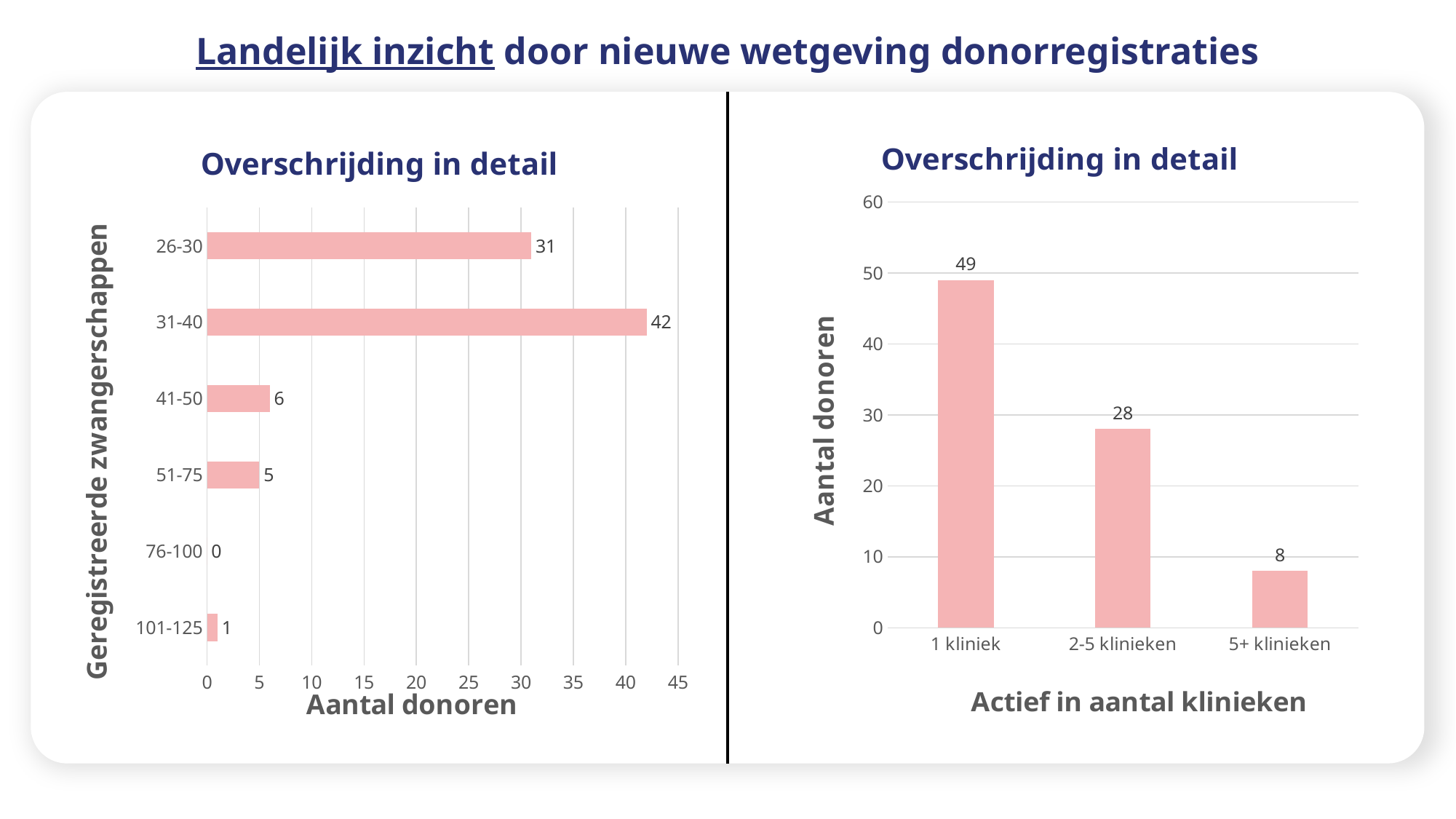
In the left chart, what is the difference in donors between the 31-40 and 26-30 categories? 11 In the right chart, how many donors are active in 1 clinic? 49 In the left chart, which category of registered pregnancies has the highest number of donors? 31-40 In the right chart, what is the difference between donors active in 1 clinic and those active in 2-5 clinics? 21 What type of chart is the right chart? bar chart In the left chart, which has more donors: 41-50 or 51-75? 41-50 In the left chart, which category has the lowest number of donors? 76-100 In the left chart, how many donors are in the 31-40 registered pregnancies category? 42 In the right chart, do the values rise or fall from left to right along the x axis? fall In the left chart, how many categories of registered pregnancies are shown? 6 In the left chart, how many donors are in the 26-30 category? 31 In the right chart, how many donors are active in 5+ clinics? 8